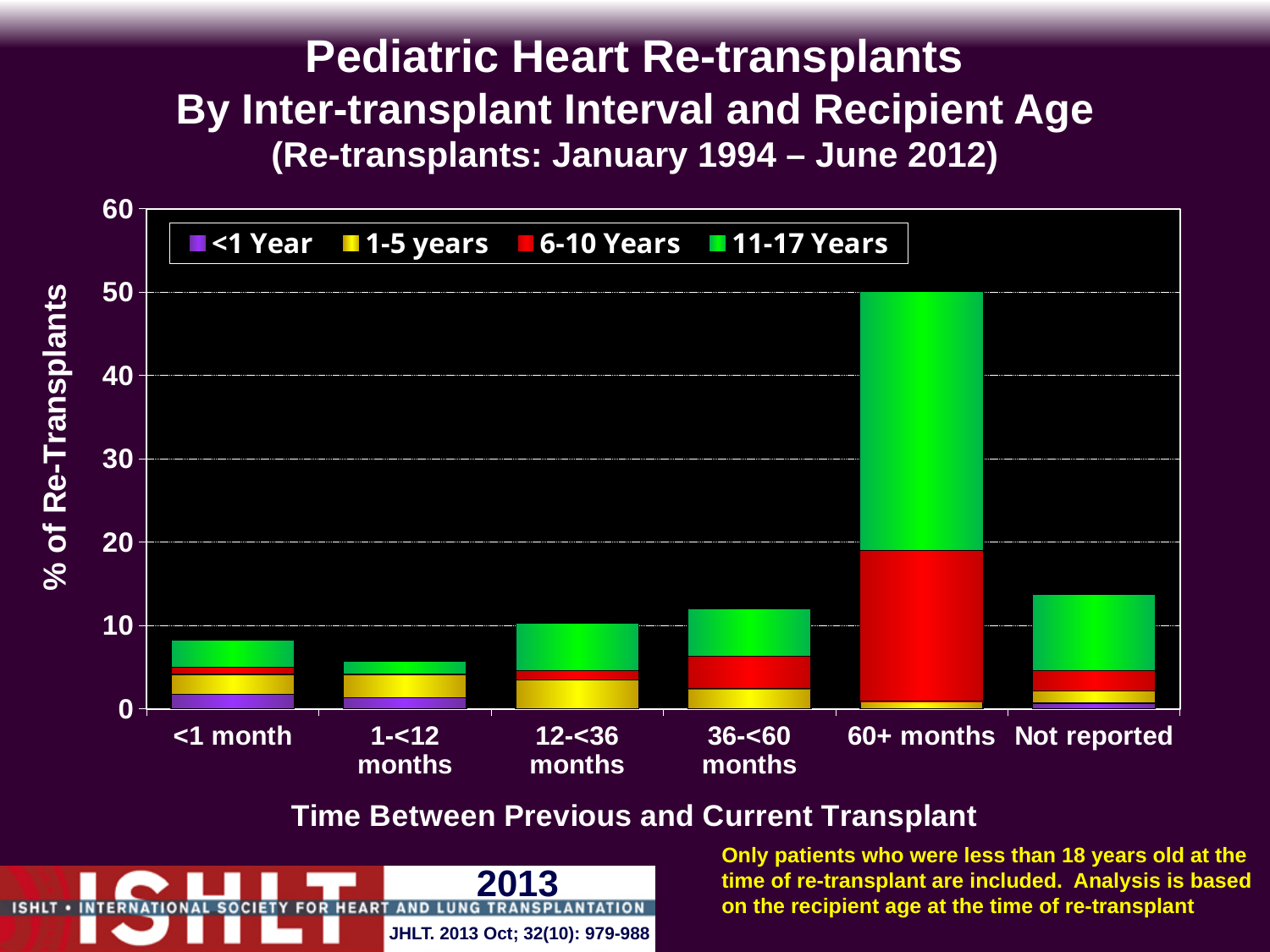
Is the total value for 60+ months greater or less than 40? greater What kind of chart is shown on the slide? Stacked bar chart How many series does the legend list? 4 What is the title of the x axis? Time Between Previous and Current Transplant Is the total value for <1 month greater or less than 10? less Do the total values rise or fall from 1-<12 months to 60+ months along the x axis? rise Which inter-transplant interval has the lowest total percentage of re-transplants? 1-<12 months Is the total value for Not reported greater or less than 10? greater How many inter-transplant interval categories are shown on the x axis? 6 Which has a larger total percentage of re-transplants, 36-<60 months or 12-<36 months? 36-<60 months Which inter-transplant interval has the highest total percentage of re-transplants? 60+ months